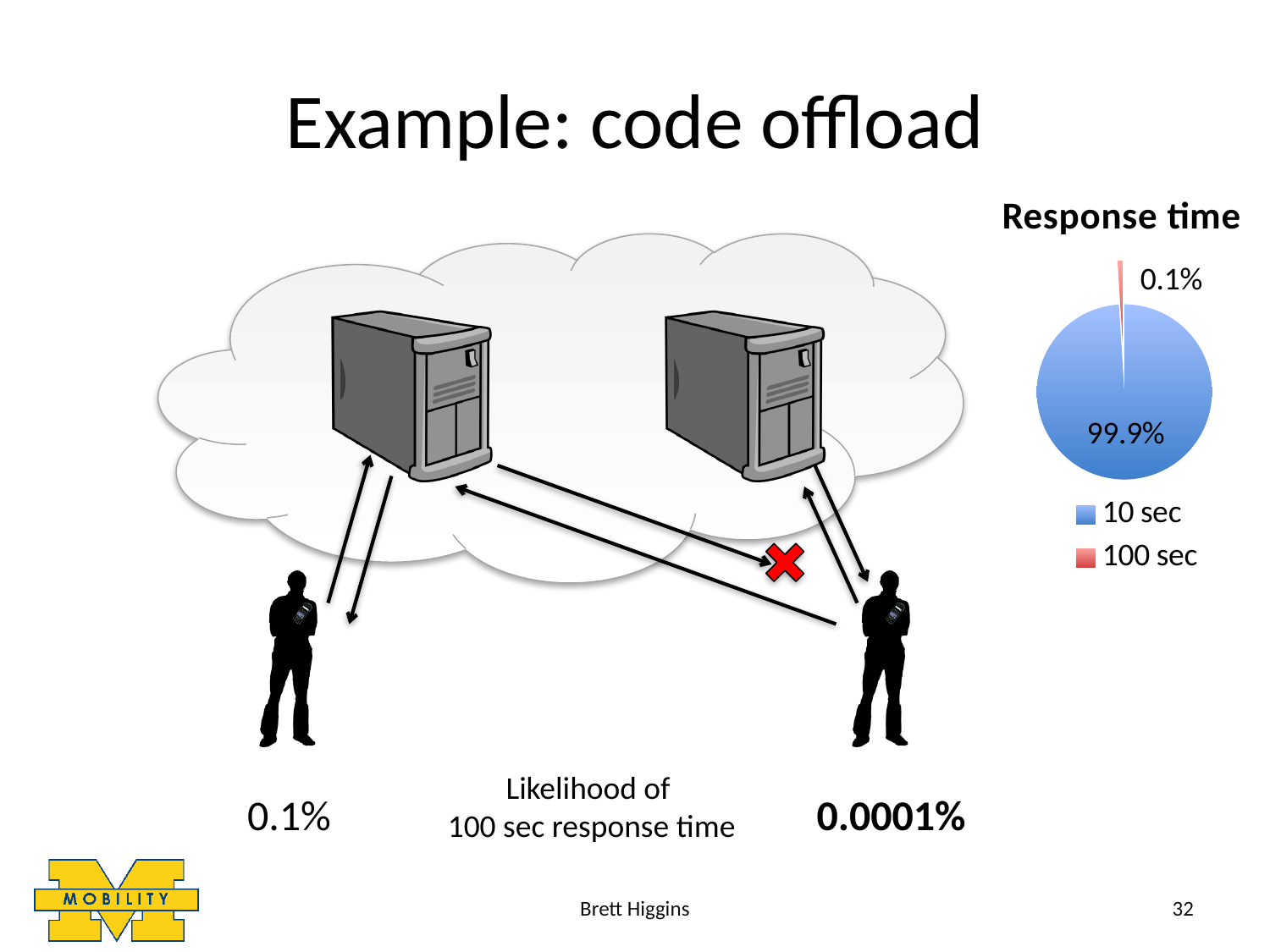
In the "Response time" pie chart, what share is labelled for the 100 sec slice? 0.1% In the "Response time" pie chart, what is the difference between the 10 sec share and the 100 sec share? 99.8% What is the title of the pie chart on the slide? Response time How many slices does the "Response time" pie chart have? 2 In the "Response time" pie chart, which slice is the smallest? 100 sec How many entries does the legend of the "Response time" pie chart list? 2 In the "Response time" pie chart, what share is labelled for the 10 sec slice? 99.9% In the "Response time" pie chart, what colour is the 100 sec slice? red What kind of chart is the "Response time" chart? pie chart In the "Response time" pie chart, which slice is the largest? 10 sec In the "Response time" pie chart, which is larger, the 10 sec slice or the 100 sec slice? 10 sec